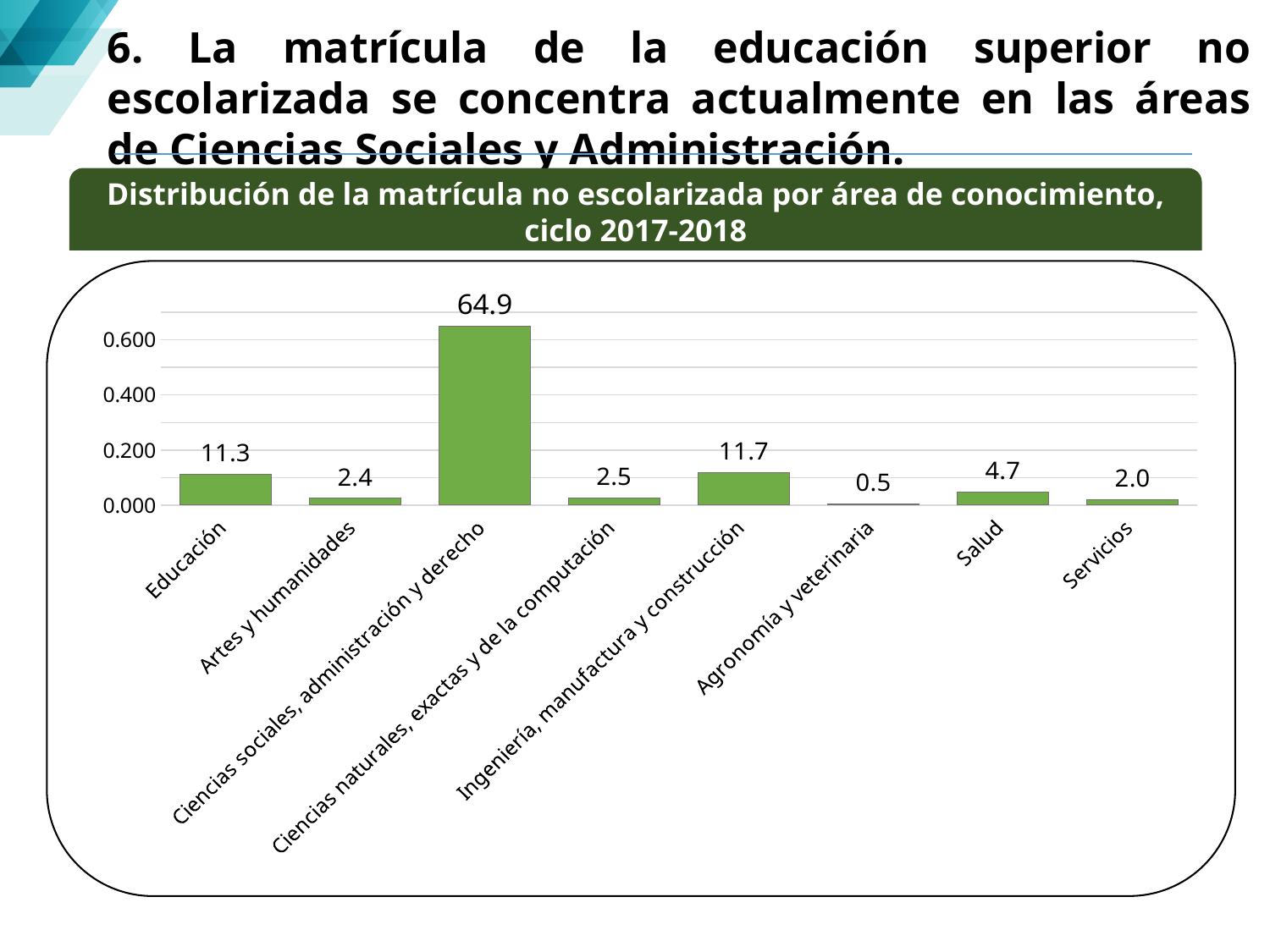
What is the value for Ciencias sociales, administración y derecho? 64.9 How many categories are shown on the x axis? 8 What is the difference between the values for Salud and Servicios? 2.7 What kind of chart is shown on the slide? Bar chart Which category has the lowest value? Agronomía y veterinaria What is the title of the chart? Distribución de la matrícula no escolarizada por área de conocimiento, ciclo 2017-2018 What is the value for Agronomía y veterinaria? 0.5 Which category has the highest value? Ciencias sociales, administración y derecho What is the value for Educación? 11.3 Which is larger, the value for Artes y humanidades or the value for Ciencias naturales, exactas y de la computación? Ciencias naturales, exactas y de la computación What is the value for Salud? 4.7 What is the difference between the values for Ingeniería, manufactura y construcción and Educación? 0.4